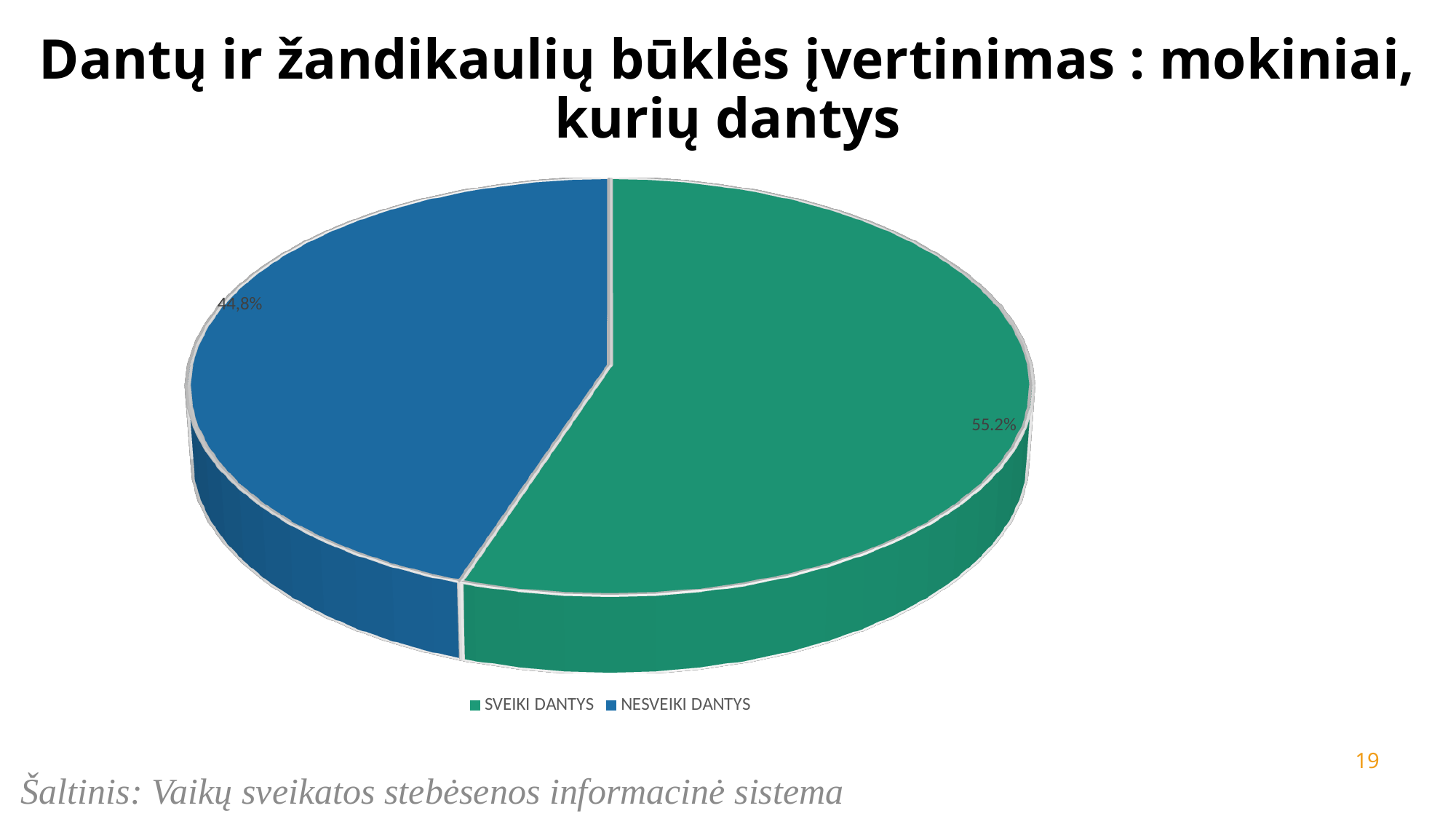
What share of the pie is labelled NESVEIKI DANTYS? 44,8% Which slice is the largest? SVEIKI DANTYS What share of the pie is labelled SVEIKI DANTYS? 55.2% What colour is the SVEIKI DANTYS slice? green What is the difference in percentage points between SVEIKI DANTYS and NESVEIKI DANTYS? 10,4 Which is larger, SVEIKI DANTYS or NESVEIKI DANTYS? SVEIKI DANTYS Which slice is the smallest? NESVEIKI DANTYS What kind of chart is shown on the slide? pie chart What is the title of the chart on the slide? Dantų ir žandikaulių būklės įvertinimas : mokiniai, kurių dantys Is the share for NESVEIKI DANTYS greater or less than 50%? less How many entries does the legend list? 2 How many slices does the pie chart have? 2